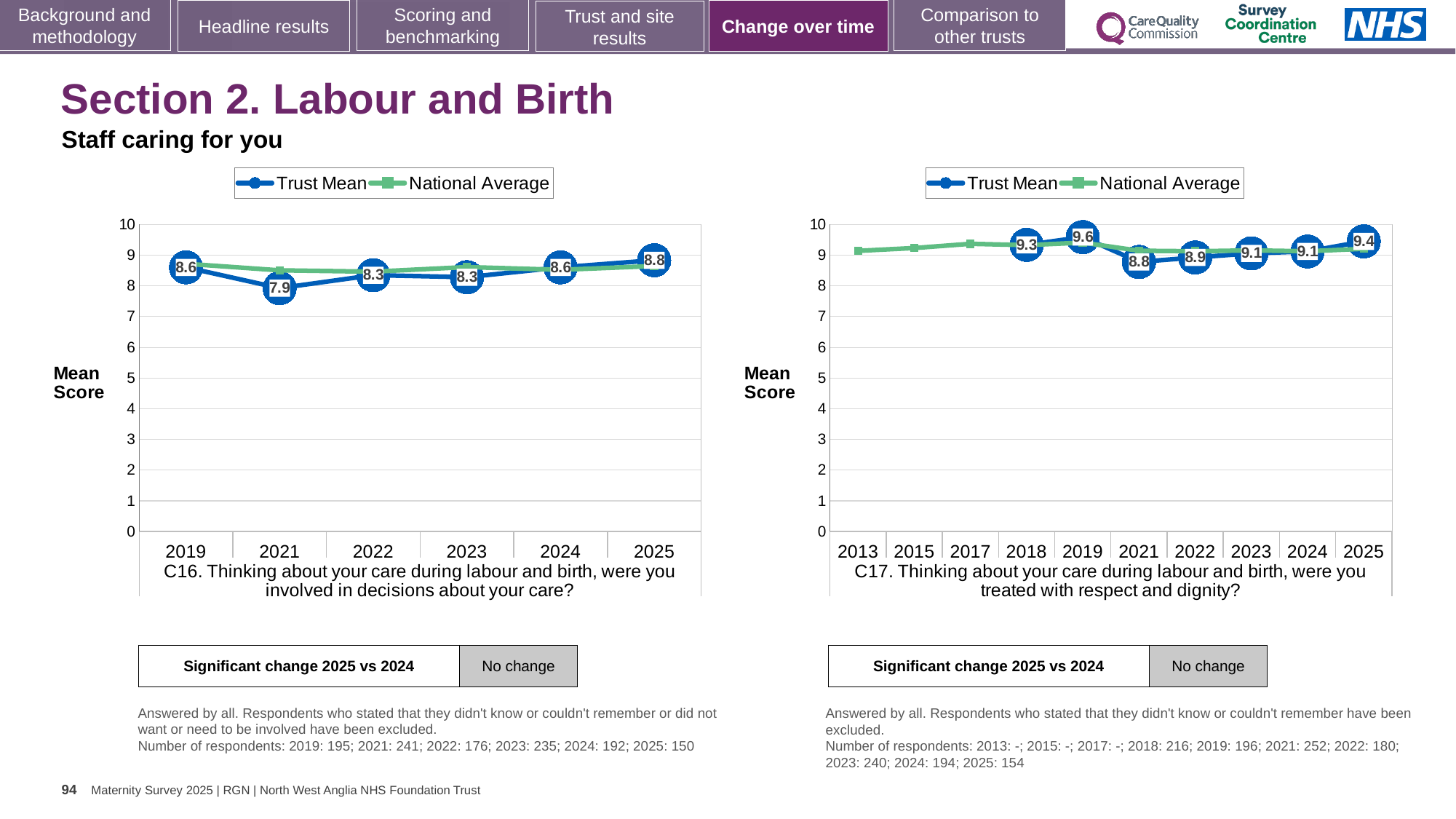
In the C17 chart on the right, what is the Trust Mean score for 2019? 9.6 In the C16 chart on the left, what is the Trust Mean score for 2025? 8.8 How many series does the legend of the C16 chart on the left list? 2 In the C16 chart on the left, which year has the lowest Trust Mean score? 2021 In the C17 chart on the right, which year has the lowest Trust Mean score? 2021 In the C17 chart on the right, which year has the highest Trust Mean score? 2019 In the C16 chart on the left, what is the Trust Mean score for 2021? 7.9 In the C16 chart on the left, what is the difference between the Trust Mean scores for 2025 and 2021? 0.9 What kind of chart is the C17 chart on the right? Line chart In the C16 chart on the left, how many years are shown on the x axis? 6 In the C17 chart on the right, is the Trust Mean score for 2025 greater or less than the Trust Mean score for 2024? greater In the C17 chart on the right, what is the difference between the Trust Mean scores for 2019 and 2021? 0.8